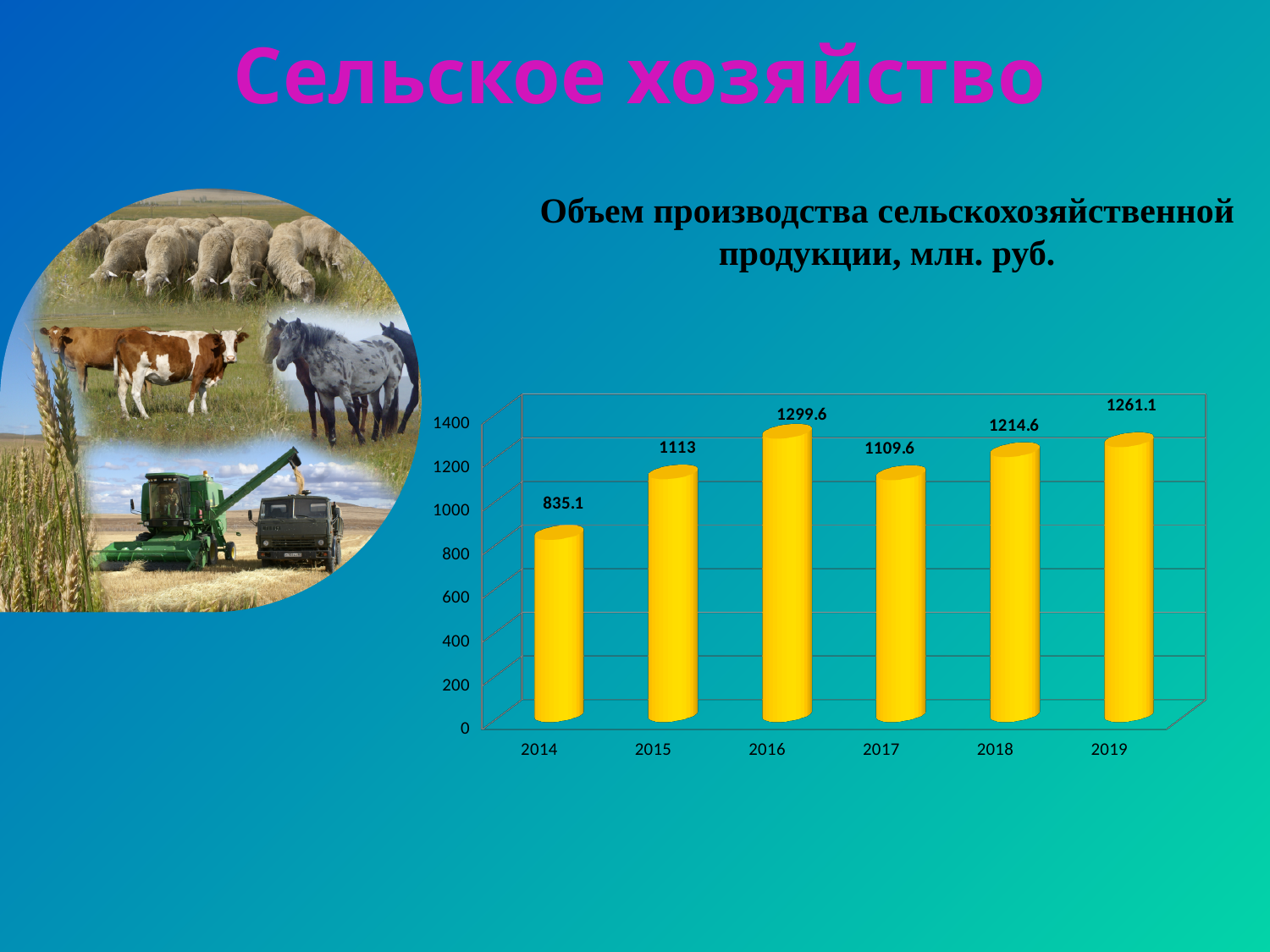
Which year has the lowest value? 2014 What kind of chart is shown? bar chart What is the title of the chart? Объем производства сельскохозяйственной продукции, млн. руб. What is the value for 2019? 1261.1 What is the difference between the values for 2019 and 2018? 46.5 Which is larger, the value for 2015 or the value for 2017? 2015 Is the value for 2018 greater or less than 1200? greater How many years are shown on the x axis? 6 What is the value for 2016? 1299.6 What is the value for 2014? 835.1 What is the difference between the values for 2016 and 2014? 464.5 Which year has the highest value? 2016